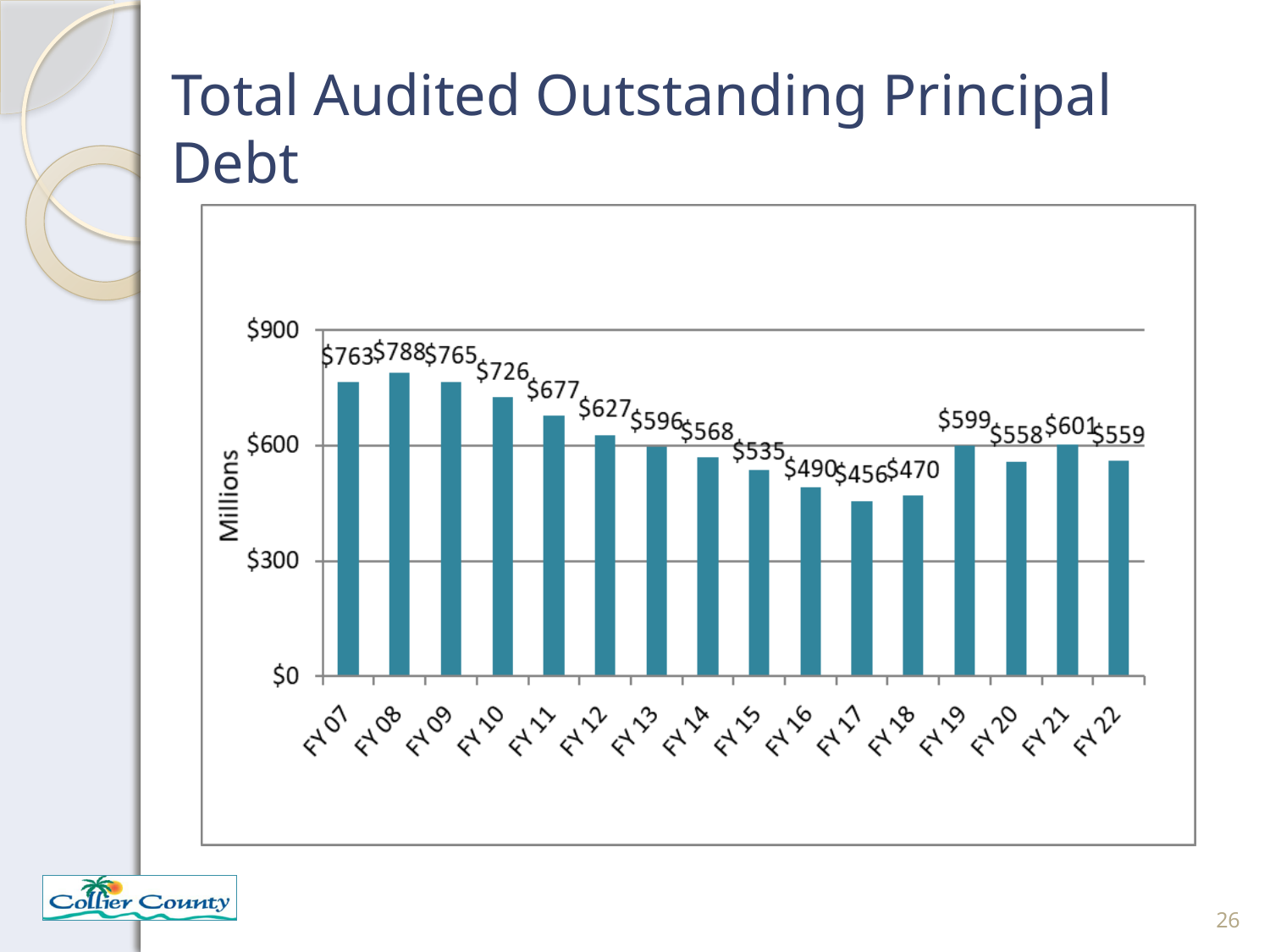
Which fiscal year has the highest value? FY 08 What kind of chart is shown on the slide? bar chart What is the label on the vertical axis? Millions How many fiscal years are shown on the x axis? 16 Which is larger, the value for FY 19 or the value for FY 20? FY 19 What is the value for FY 08? $788 What is the value for FY 17? $456 Do the values rise or fall from FY 08 to FY 17? fall What is the difference between the values for FY 07 and FY 22? $204 Is the value for FY 16 greater or less than $600? less What is the value for FY 21? $601 Which fiscal year has the lowest value? FY 17